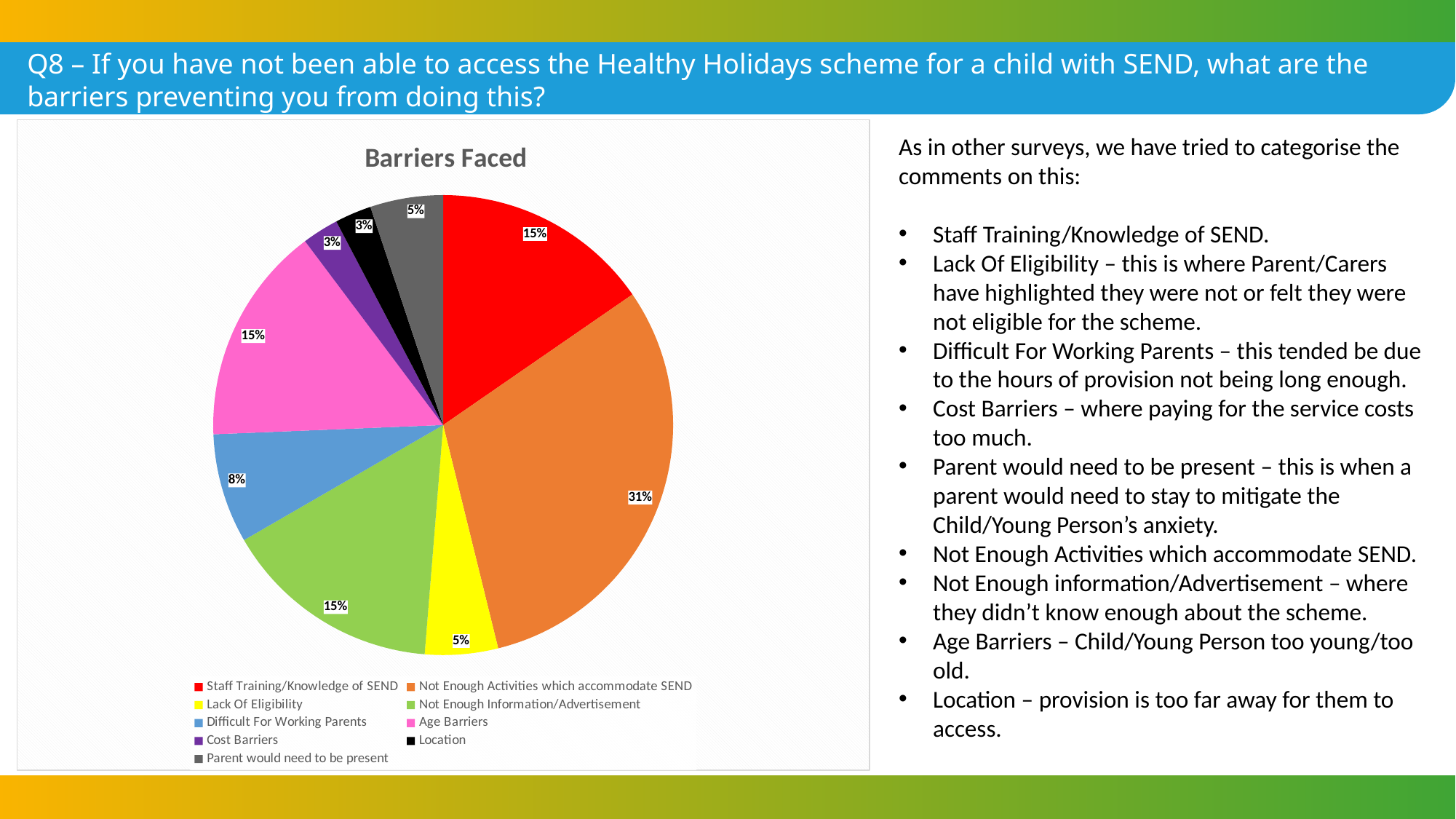
What colour is the slice for Location? black What is the value for Cost Barriers? 3% How many categories does the pie chart have? 9 What type of chart is shown on the slide? pie chart What is the value for Difficult For Working Parents? 8% Which is larger, the share for Difficult For Working Parents or the share for Parent would need to be present? Difficult For Working Parents What share of the pie is Not Enough Activities which accommodate SEND? 31% What is the value for Lack Of Eligibility? 5% Which category has the largest share of the pie? Not Enough Activities which accommodate SEND What is the title of the chart? Barriers Faced What is the value for Staff Training/Knowledge of SEND? 15% What is the difference between the shares for Not Enough Activities which accommodate SEND and Age Barriers? 16%